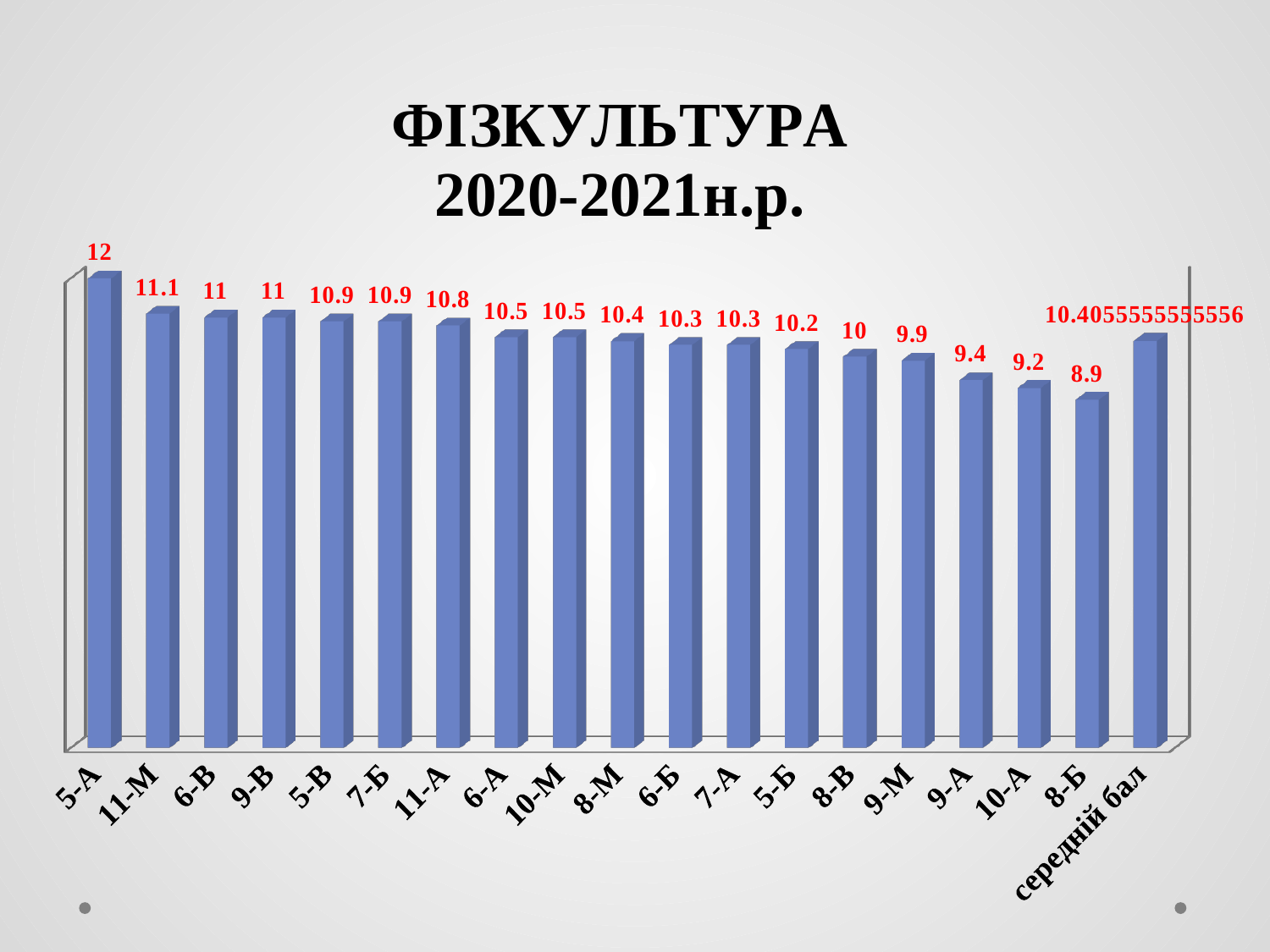
Which category has the lowest value? 8-Б What is the value for 11-М? 11.1 What is the title of the chart? ФІЗКУЛЬТУРА 2020-2021н.р. What is the value for 5-А? 12 What is the difference between the values for 5-А and 8-Б? 3.1 Which category has the highest value? 5-А What is the value for 8-Б? 8.9 Which is larger, the value for 9-А or the value for 10-А? 9-А What kind of chart is shown on the slide? bar chart What is the value shown for середній бал? 10.4055555555556 What is the difference between the values for 11-А and 9-М? 0.9 How many bars are plotted on the chart? 19